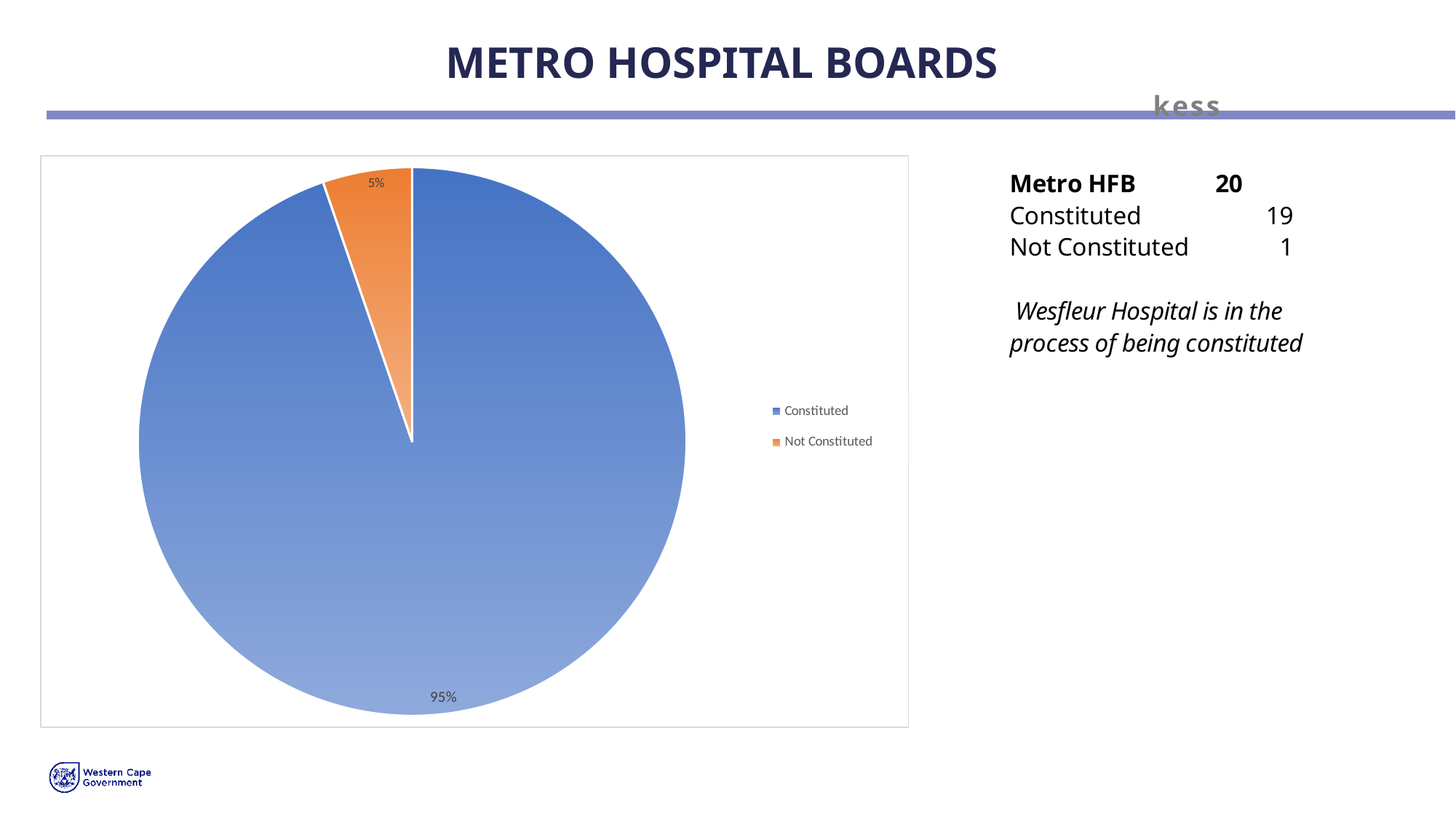
What colour is the Constituted slice in the pie chart? blue What percentage of the pie chart is labelled Constituted? 95% What percentage of the pie chart is labelled Not Constituted? 5% How many slices does the pie chart have? 2 Which slice of the pie chart is the largest? Constituted Which is larger in the pie chart, Constituted or Not Constituted? Constituted How many entries does the legend of the pie chart list? 2 What kind of chart is shown on the slide? pie chart What is the difference in percentage points between the Constituted and Not Constituted slices? 90 Which slice of the pie chart is the smallest? Not Constituted What colour is the Not Constituted slice in the pie chart? orange